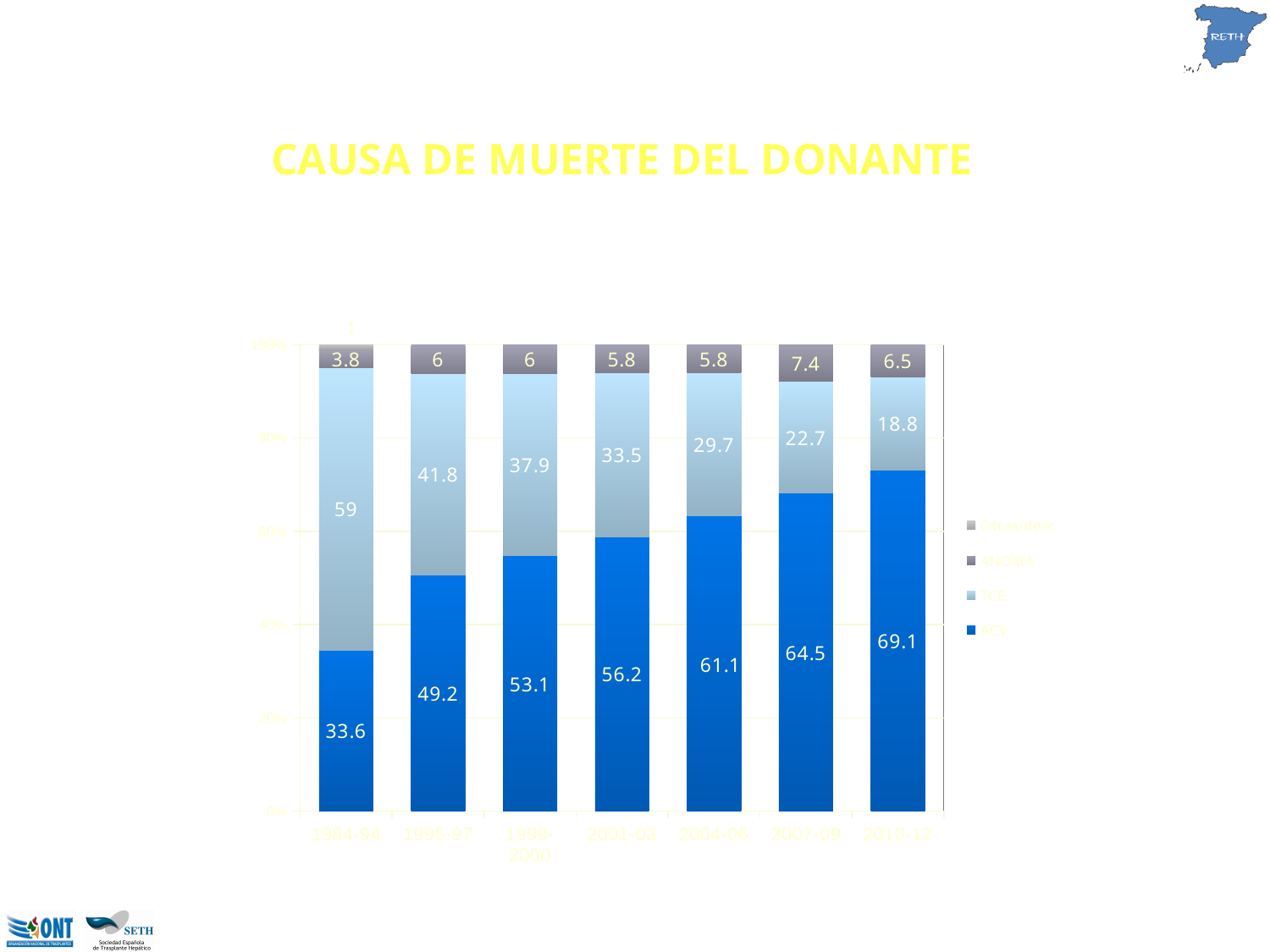
What is the ACV value for the 2010-12 period? 69.1 Which period has the lowest TCE value? 2010-12 What is the title of the chart? CAUSA DE MUERTE DEL DONANTE What kind of chart is shown on the slide? Stacked bar chart How many series does the legend list? 4 What is the ACV value for the 2001-03 period? 56.2 Which period has the highest ACV value? 2010-12 In the 1995-97 period, which is larger, the ACV value or the TCE value? ACV Do the ACV values rise or fall from 1984-94 to 2010-12? Rise What is the TCE value for the 1984-94 period? 59 What is the difference between the ACV value in 2010-12 and the ACV value in 1984-94? 35.5 How many periods are shown on the x axis? 7